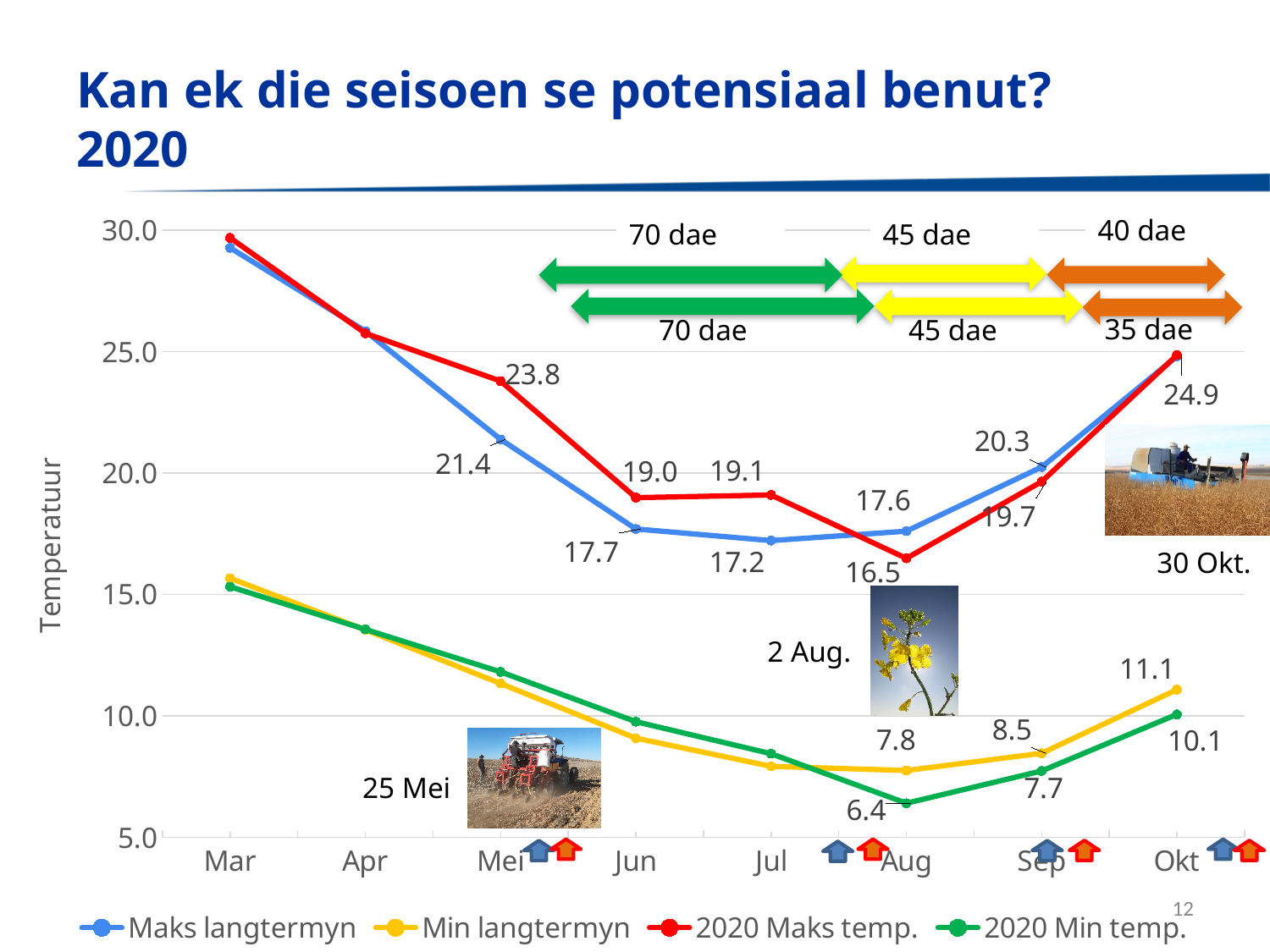
What is the 2020 Min temp. value for Aug? 6.4 What is the difference between Maks langtermyn and 2020 Maks temp. in Aug? 1.1 In Sep, which is larger: Min langtermyn or 2020 Min temp.? Min langtermyn What is the 2020 Maks temp. value for Mei? 23.8 How many series does the legend list? 4 Does the 2020 Maks temp. series rise or fall from Mar to Aug? fall How many months are shown on the x axis? 8 What kind of chart is shown on the slide? line chart What is the Min langtermyn value for Okt? 11.1 Is the Maks langtermyn value for Mar greater or less than 25.0? greater What is the title of the y axis? Temperatuur What is the Maks langtermyn value for Jul? 17.2